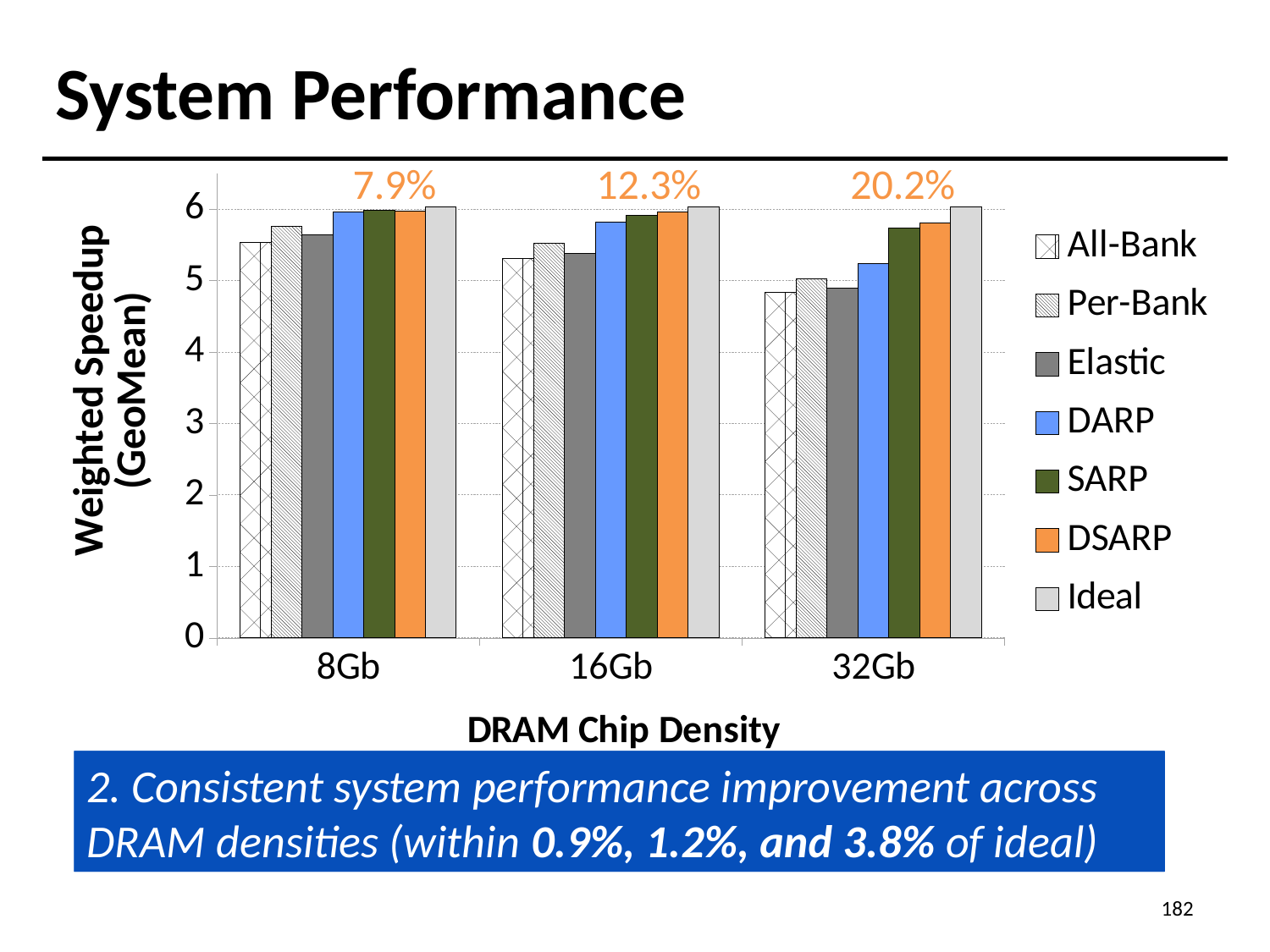
Is the value for Elastic at 16Gb greater or less than 5? greater Is the value for Ideal at 8Gb greater or less than 5? greater Do the All-Bank values rise or fall as DRAM chip density increases from 8Gb to 32Gb? fall How many series does the legend list? 7 What kind of chart is shown on the slide? bar chart Is the value for DARP at 32Gb greater or less than 5? greater What percentage is printed above the 32Gb group of bars? 20.2% How many DRAM chip density categories are shown on the x axis? 3 What is the title of the y axis? Weighted Speedup (GeoMean) Which series has the highest value at 32Gb? Ideal Which is larger at 32Gb, DSARP or Elastic? DSARP